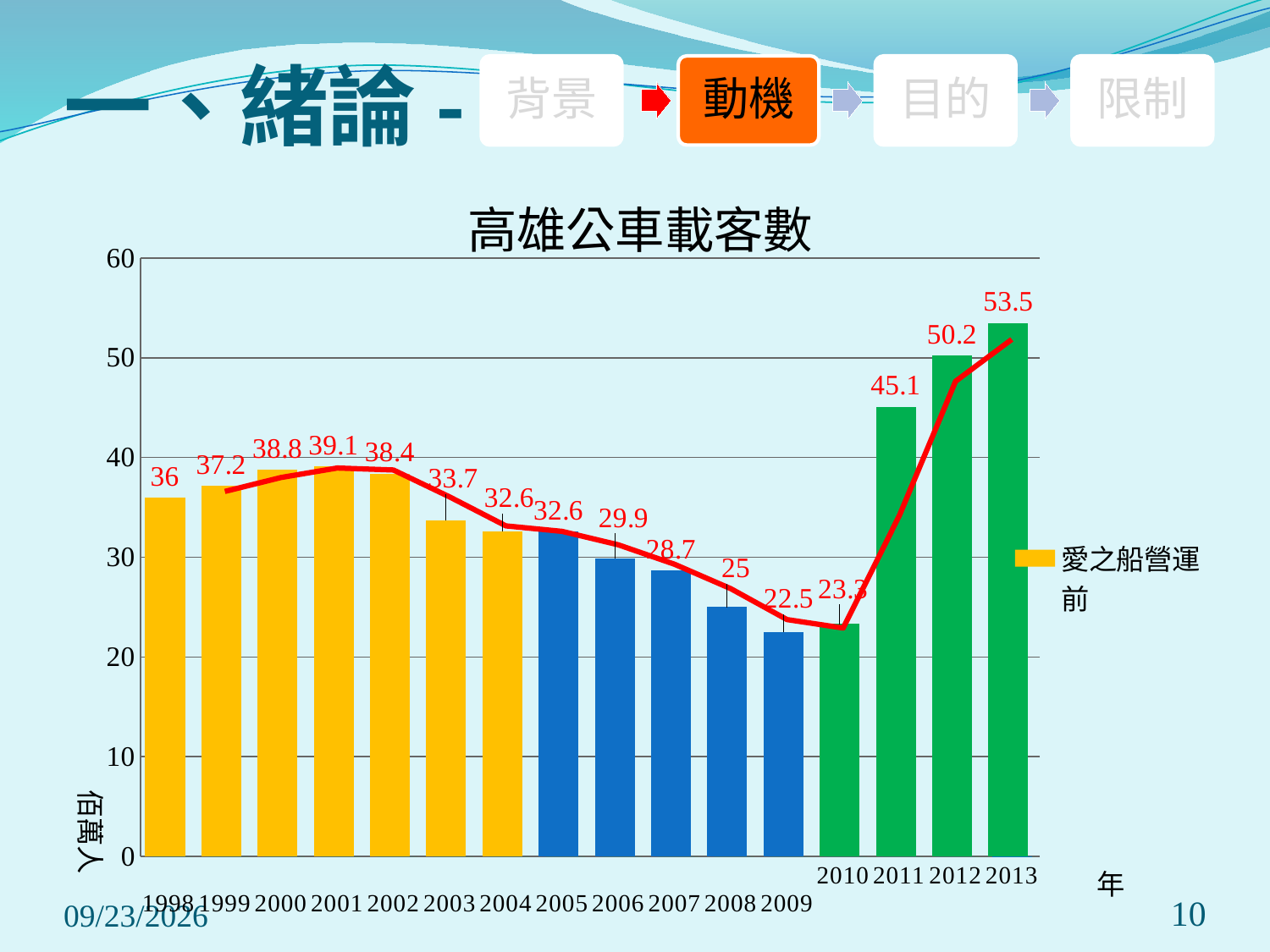
What is the value for 2013 in the 高雄公車載客數 chart? 53.5 What is the value for 2001 in the 高雄公車載客數 chart? 39.1 Which year has the lowest value in the 高雄公車載客數 chart? 2009 Which year has the highest value in the 高雄公車載客數 chart? 2013 What kind of chart is shown on the slide? Bar chart with a line What is the title of the chart? 高雄公車載客數 What is the difference between the values for 2011 and 2010? 21.8 How many years are shown on the x axis of the chart? 16 Which is larger, the value for 1998 or the value for 2010? 1998 What is the value for 2009 in the 高雄公車載客數 chart? 22.5 Is the value for 2012 greater or less than 50? greater What is the difference between the values for 2013 and 2012? 3.3